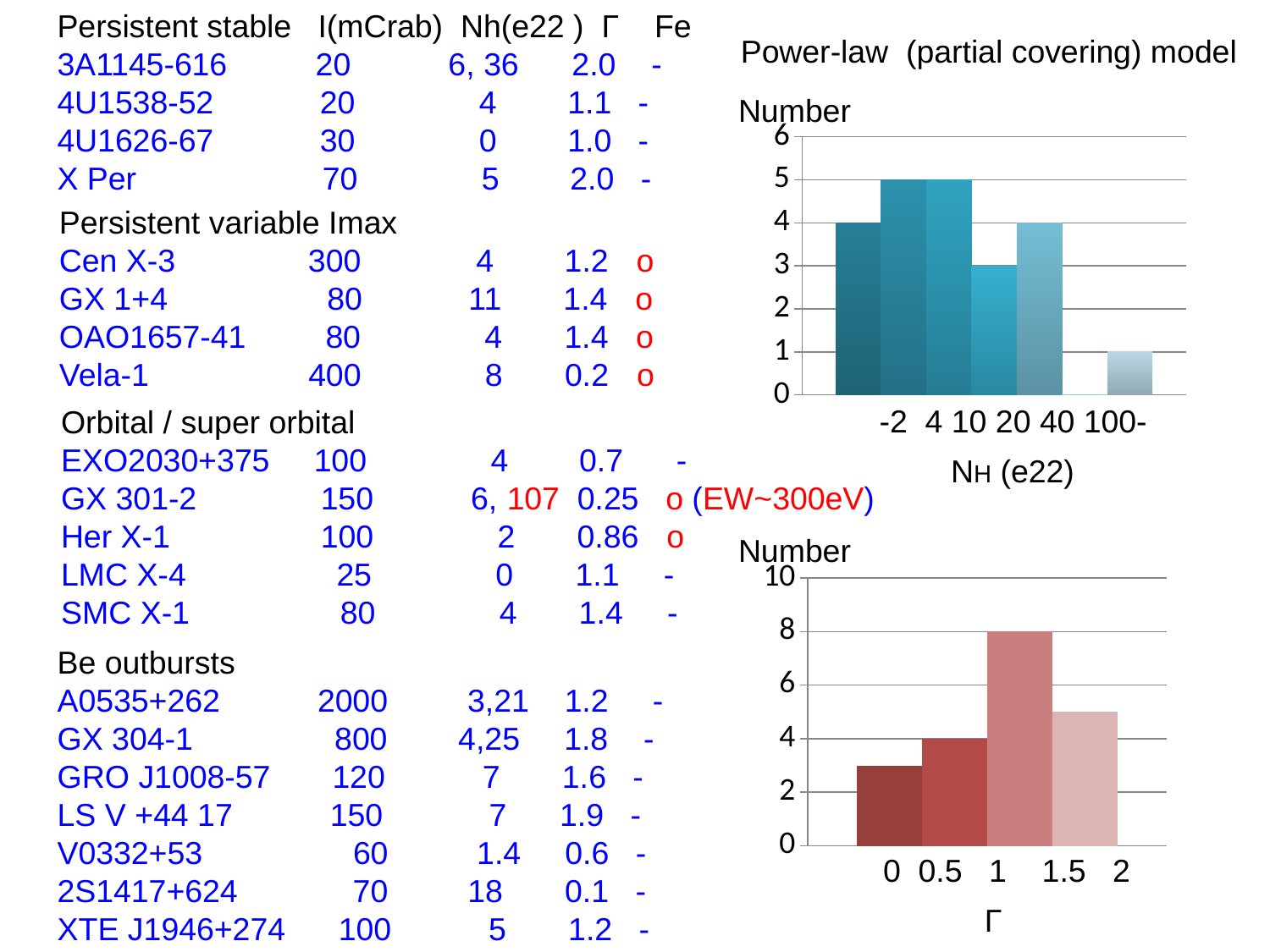
In the top chart (NH), is the leftmost bar taller or shorter than the rightmost bar? taller In the bottom chart (Γ), what is the height of the tallest bar? 8 In the top chart (NH), what is the height of the tallest bars? 5 In the top chart (NH), what is the value of the leftmost bar? 4 What kind of chart is the bottom chart on the right, labelled Γ? bar chart What kind of chart is the top chart on the right, labelled NH (e22)? bar chart What is the title written above the top chart? Power-law (partial covering) model In the top chart (NH), what is the value of the rightmost bar? 1